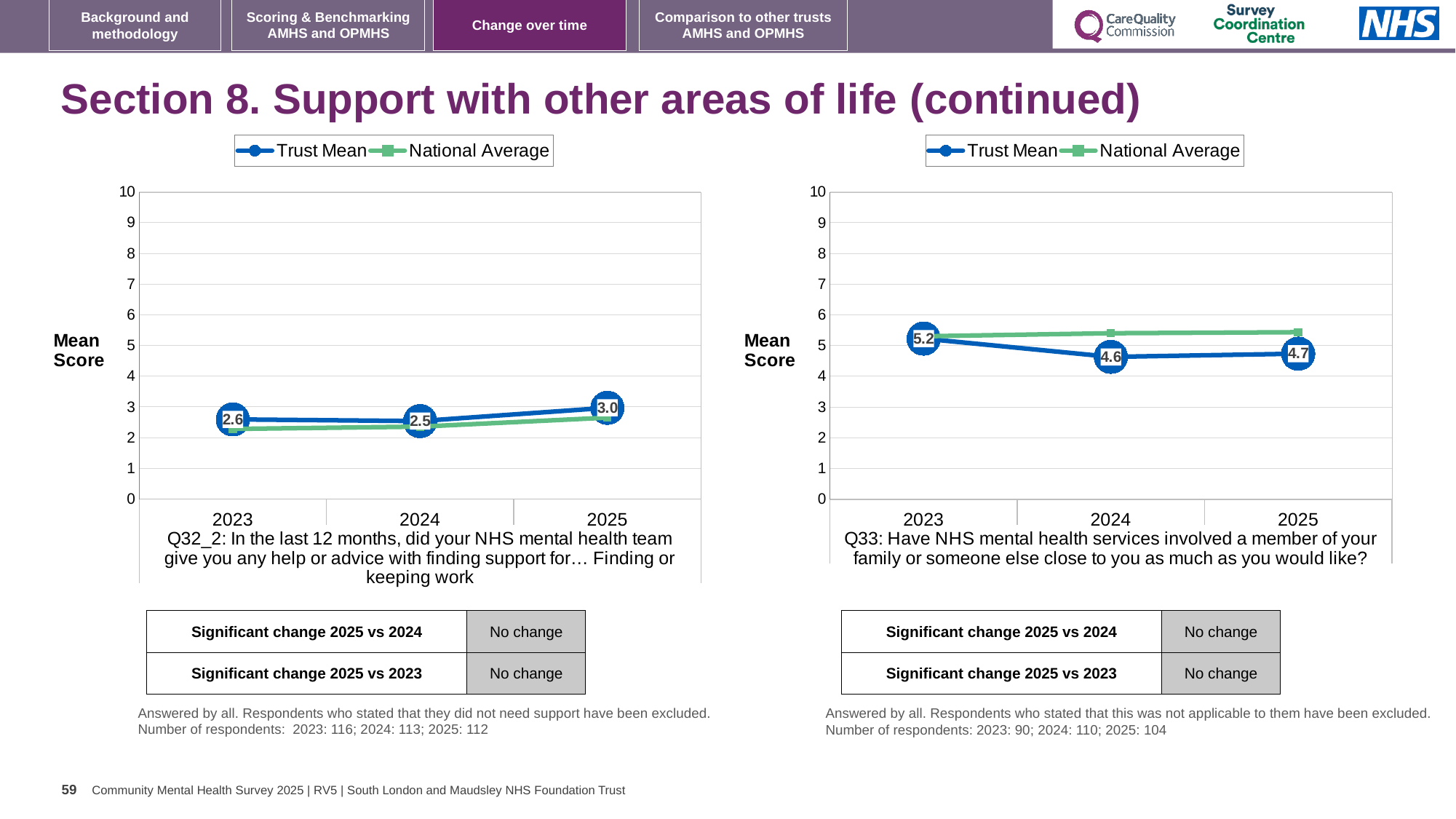
In the left chart (Q32_2), which year has the lowest Trust Mean score? 2024 In the left chart (Q32_2), what is the difference between the Trust Mean scores for 2025 and 2024? 0.5 In the right chart (Q33), what is the difference between the Trust Mean scores for 2023 and 2024? 0.6 In the right chart (Q33), which is larger in 2024, the Trust Mean or the National Average? National Average In the right chart (Q33), which year has the highest Trust Mean score? 2023 What kind of chart is the right chart (Q33)? Line chart How many series does the legend of the left chart (Q32_2) list? 2 In the left chart (Q32_2), what is the Trust Mean score for 2024? 2.5 In the left chart (Q32_2), what is the Trust Mean score for 2025? 3.0 In the right chart (Q33), is the National Average for 2024 greater or less than 5? greater In the right chart (Q33), what is the Trust Mean score for 2023? 5.2 In the right chart (Q33), what is the Trust Mean score for 2024? 4.6